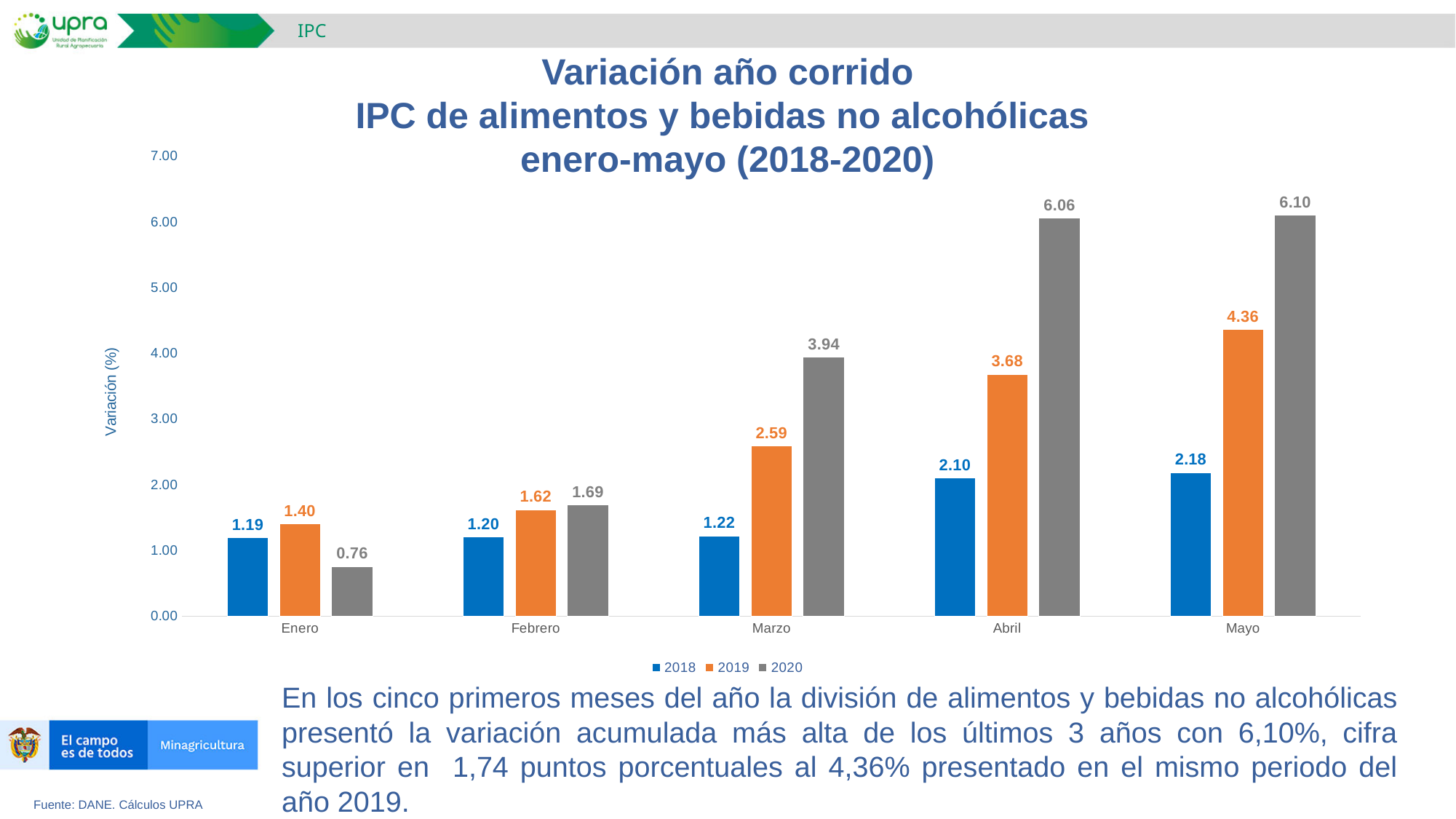
How many months are shown on the x axis? 5 What is the value for 2019 in Marzo? 2.59 How many series does the legend list? 3 What is the label of the y axis? Variación (%) Which is larger in Enero, the value for 2019 or the value for 2020? 2019 Which month has the highest value for the 2020 series? Mayo Which month has the lowest value for the 2020 series? Enero What is the value for 2020 in Mayo? 6.10 What is the value for 2018 in Abril? 2.10 Is the value for 2020 in Abril greater or less than 5.00? greater What kind of chart is shown on the slide? Bar chart What is the difference between the 2020 and 2019 values in Mayo? 1.74